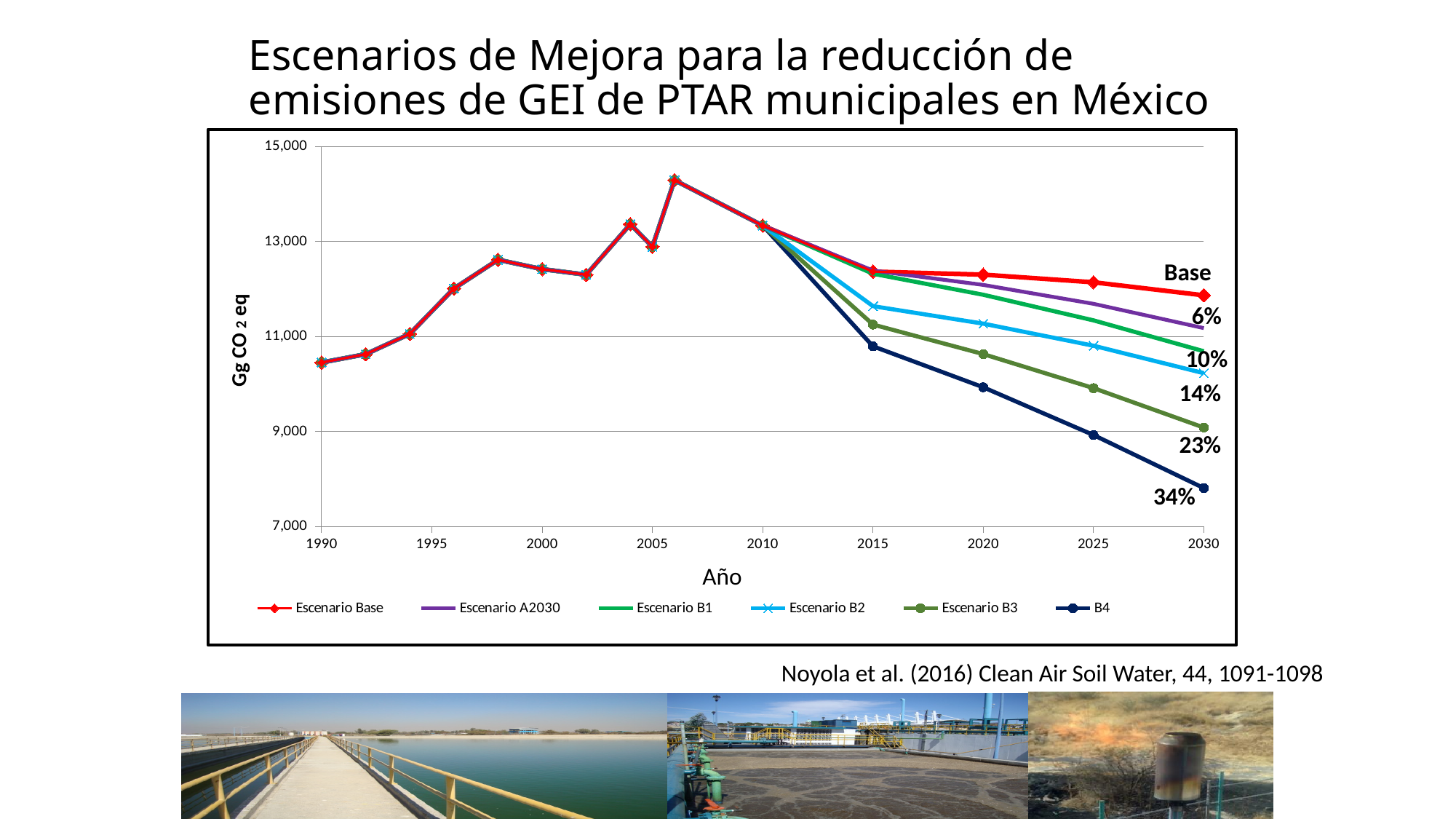
How many series does the legend list? 6 What is the label of the y axis? Gg CO2 eq What kind of chart is shown on the slide? line chart What percentage label is printed next to the end of the B4 line? 34% Which series has the highest value in 2030? Escenario Base In 2030, which is larger: the value for B4 or the value for Escenario B3? Escenario B3 Do the values rise or fall between 1990 and 2006? rise Is the value for Escenario Base in 2030 greater or less than 11,000? greater Which series has the lowest value in 2030? B4 Is the value for B4 in 2030 greater or less than 9,000? less Is the value for Escenario B2 in 2030 greater or less than 11,000? less